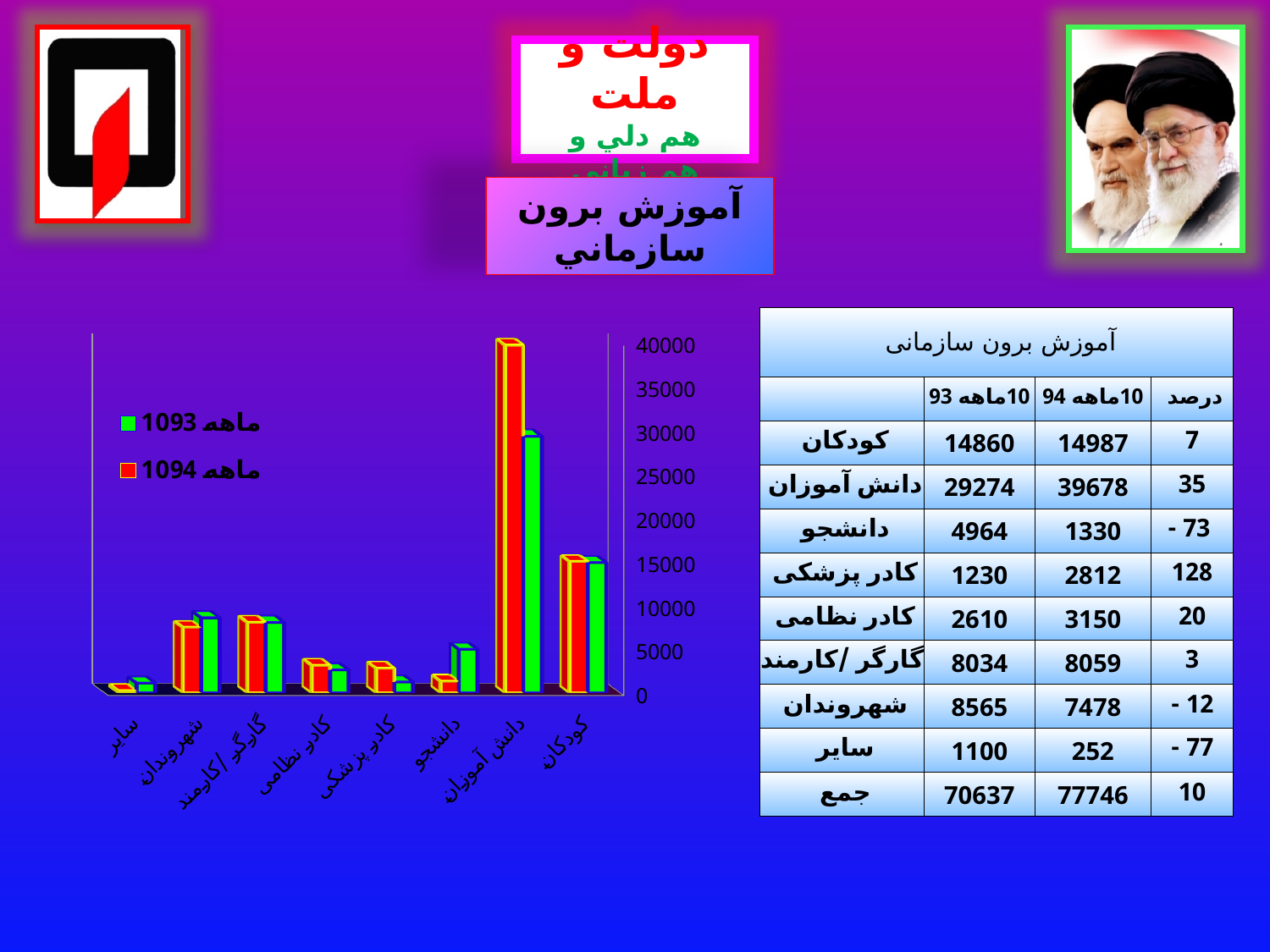
What colour are the bars for the ماهه 1094 series? red How many categories are shown on the chart's x axis? 8 How many series does the chart legend list? 2 Which category has the shortest bars in the chart? سایر Is the ماهه 1094 value for دانش آموزان greater or less than 35000? greater What kind of chart is shown on the slide? bar chart Which category has the tallest bars in the chart? دانش آموزان For دانش آموزان, which series has the larger bar, ماهه 1093 or ماهه 1094? ماهه 1094 For دانشجو, which series has the larger bar, ماهه 1093 or ماهه 1094? ماهه 1093 Is the ماهه 1093 value for کارگر/کارمند greater or less than 5000? greater Is the ماهه 1094 value for کودکان greater or less than 20000? less For کادر پزشکی, which series has the larger bar, ماهه 1093 or ماهه 1094? ماهه 1094